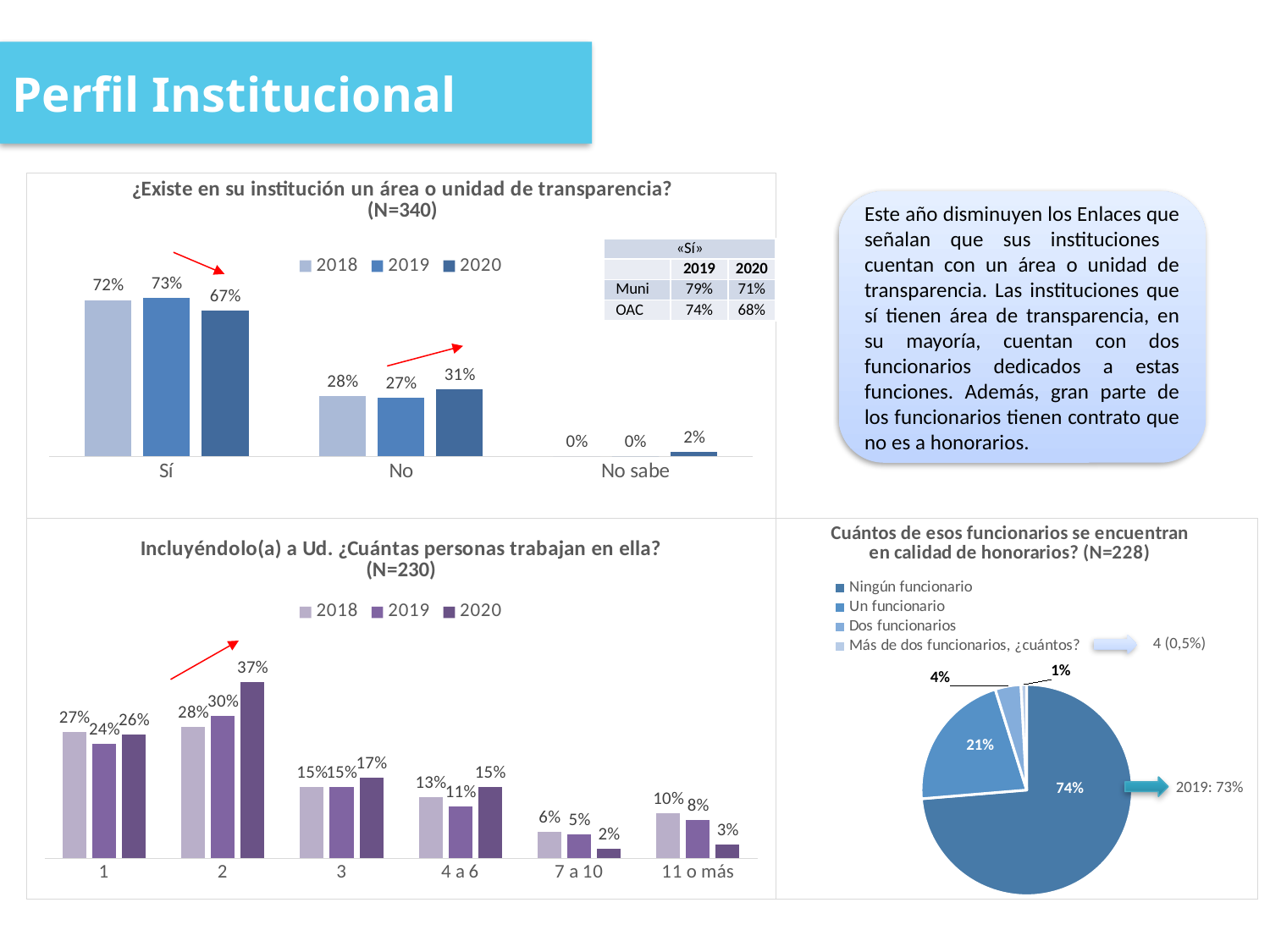
In the chart '¿Existe en su institución un área o unidad de transparencia?', how many series does the legend list? 3 In the chart 'Incluyéndolo(a) a Ud. ¿Cuántas personas trabajan en ella?', which is larger for '11 o más': the 2018 value or the 2020 value? 2018 In the chart 'Incluyéndolo(a) a Ud. ¿Cuántas personas trabajan en ella?', how many categories are shown on the x axis? 6 In the chart 'Incluyéndolo(a) a Ud. ¿Cuántas personas trabajan en ella?', which category has the lowest 2020 value? 7 a 10 In the chart 'Incluyéndolo(a) a Ud. ¿Cuántas personas trabajan en ella?', what is the value for category '2' in 2020? 37% What kind of chart is 'Cuántos de esos funcionarios se encuentran en calidad de honorarios?'? Pie chart In the chart '¿Existe en su institución un área o unidad de transparencia?', what is the value for 'No' in 2019? 27% In the chart '¿Existe en su institución un área o unidad de transparencia?', what is the difference between the 2019 and 2020 values for 'Sí'? 6% In the chart '¿Existe en su institución un área o unidad de transparencia?', what is the value for 'Sí' in 2020? 67% In the pie chart 'Cuántos de esos funcionarios se encuentran en calidad de honorarios?', what share is 'Un funcionario'? 21% In the chart 'Incluyéndolo(a) a Ud. ¿Cuántas personas trabajan en ella?', which category has the highest 2020 value? 2 In the pie chart 'Cuántos de esos funcionarios se encuentran en calidad de honorarios?', which slice is the largest? Ningún funcionario